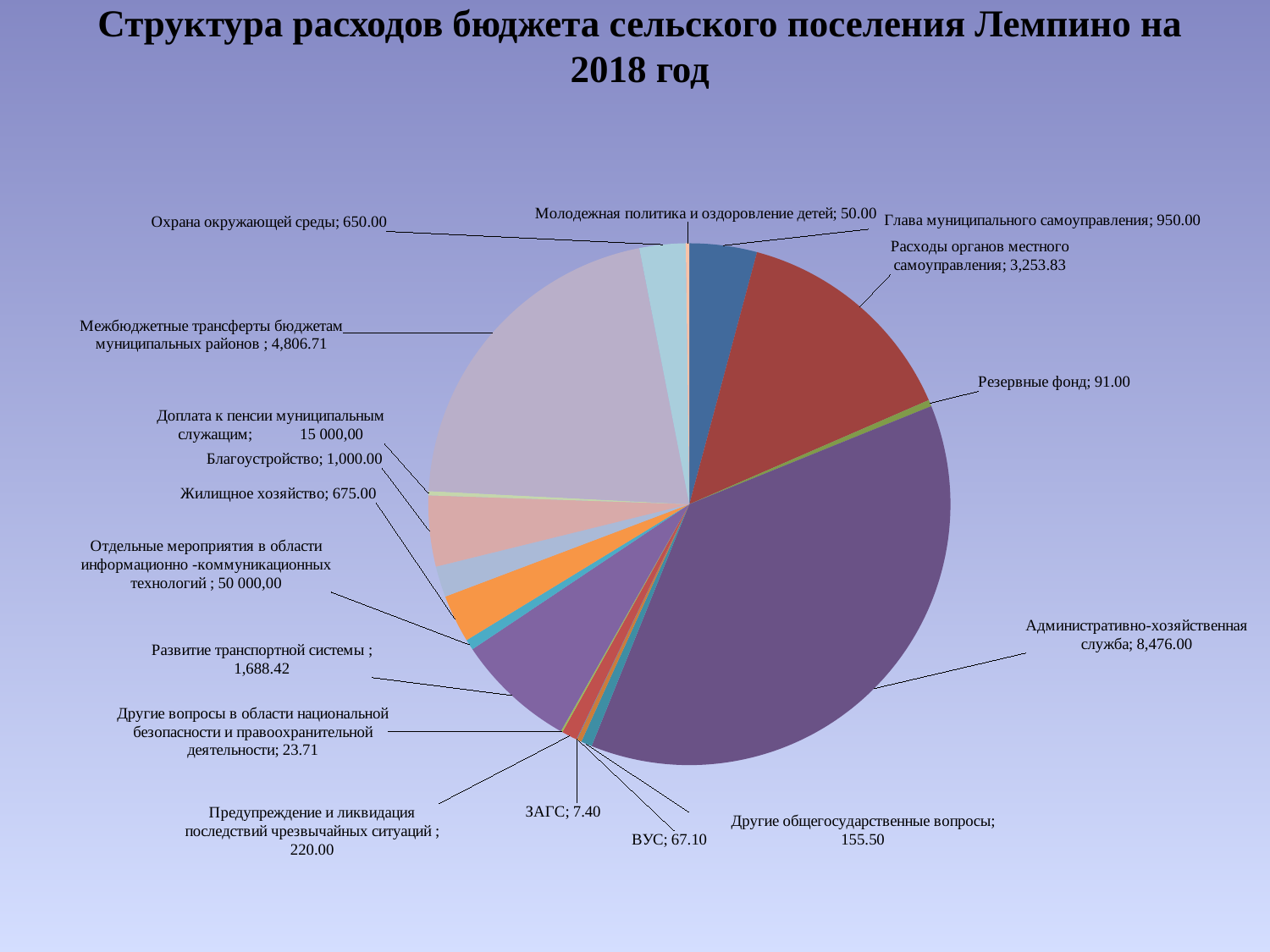
Which is larger: the value for Благоустройство or the value for Жилищное хозяйство? Благоустройство What is the value for Развитие транспортной системы? 1,688.42 What is the value for Резервные фонд? 91.00 What is the value for Административно-хозяйственная служба? 8,476.00 Which category has the smallest slice of the pie? ЗАГС What is the value for Расходы органов местного самоуправления? 3,253.83 What is the value for ЗАГС? 7.40 What is the value for Межбюджетные трансферты бюджетам муниципальных районов? 4,806.71 How many categories are shown in the pie chart? 18 What is the difference between the values for Глава муниципального самоуправления and Охрана окружающей среды? 300.00 What kind of chart is shown on the slide? pie chart Which category has the largest slice of the pie? Административно-хозяйственная служба